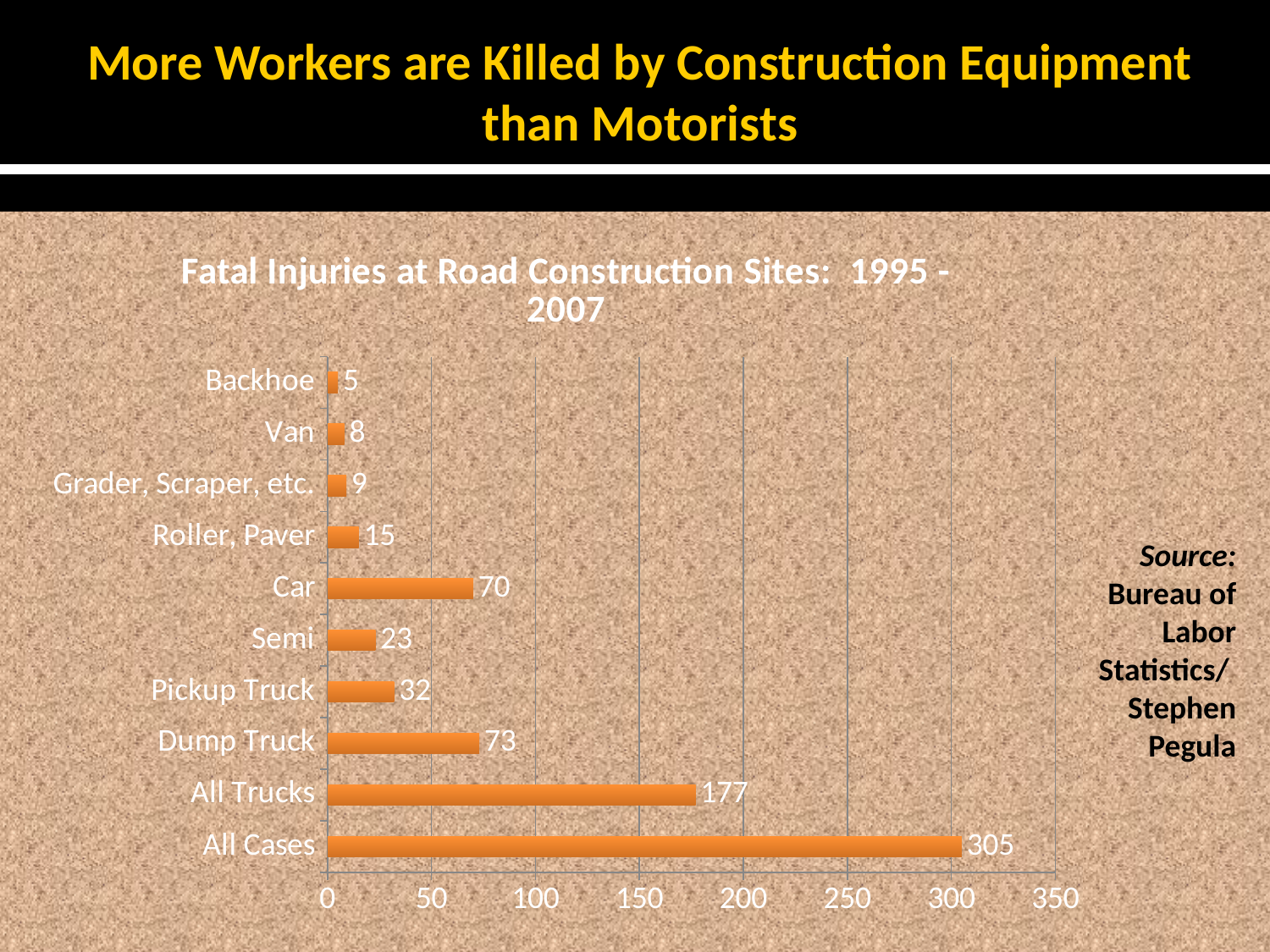
Which category has the lowest value? Backhoe What is the title of the chart? Fatal Injuries at Road Construction Sites: 1995 - 2007 Which is larger, Dump Truck or Pickup Truck? Dump Truck What is the difference between All Cases and All Trucks? 128 What kind of chart is shown on the slide? bar chart How many categories are shown in the chart? 10 Which category has the highest value? All Cases What is the difference between Pickup Truck and Semi? 9 Is the value for All Trucks greater or less than 150? greater What is the value for Roller, Paver? 15 What is the value for Dump Truck? 73 What is the value for Car? 70